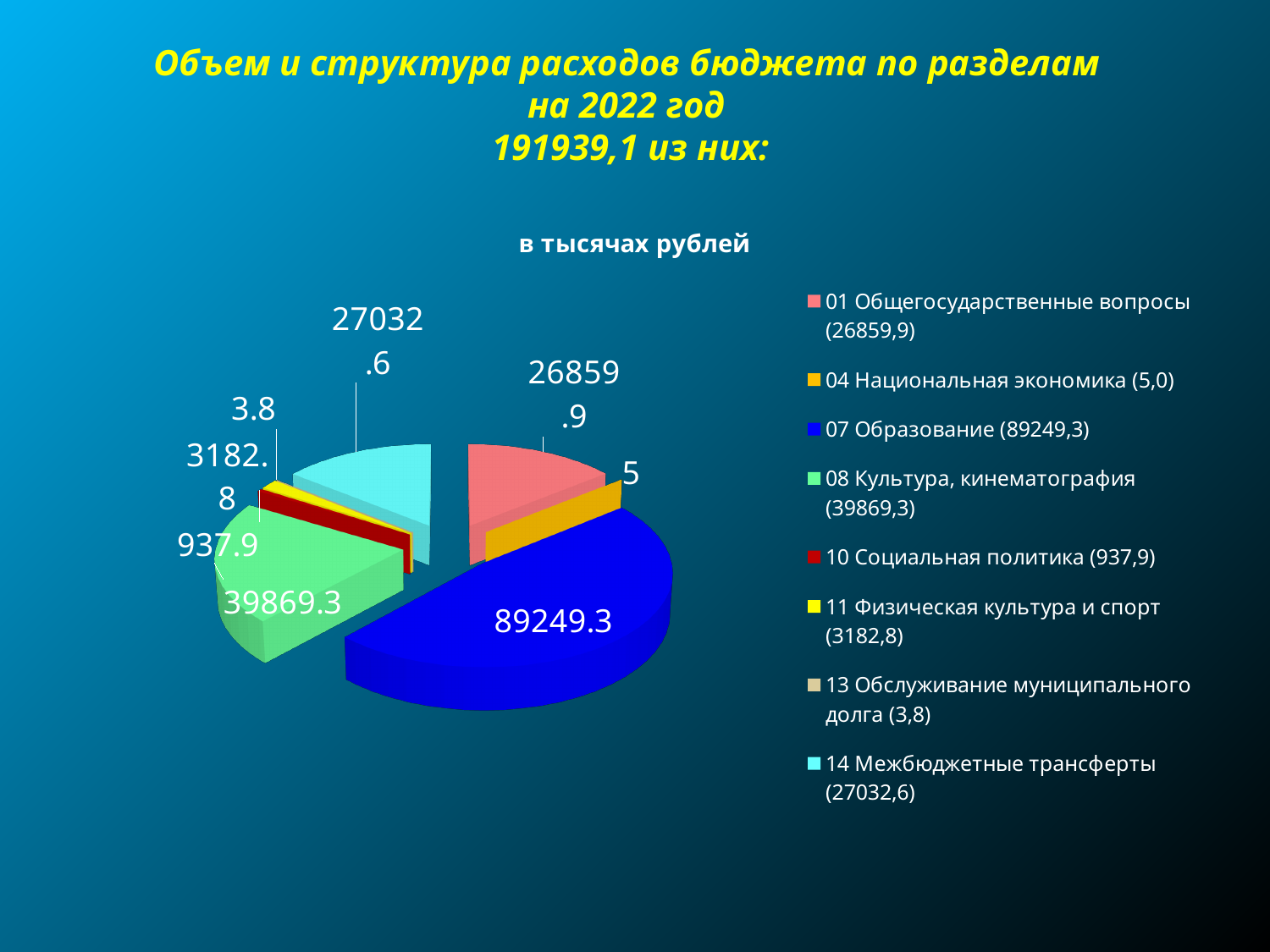
What is the difference between the values for 07 Образование and 08 Культура, кинематография? 49380 How many entries does the legend list? 8 What is the value shown for 07 Образование? 89249.3 How many slices does the pie chart have? 8 Which section has the largest share of the pie? 07 Образование Which section has the smallest value? 13 Обслуживание муниципального долга What is the value shown for 11 Физическая культура и спорт? 3182.8 What unit is stated above the chart? в тысячах рублей Which is larger: 14 Межбюджетные трансферты or 01 Общегосударственные вопросы? 14 Межбюджетные трансферты What is the value shown for 10 Социальная политика? 937.9 What kind of chart is shown on the slide? pie chart What is the value shown for 08 Культура, кинематография? 39869.3